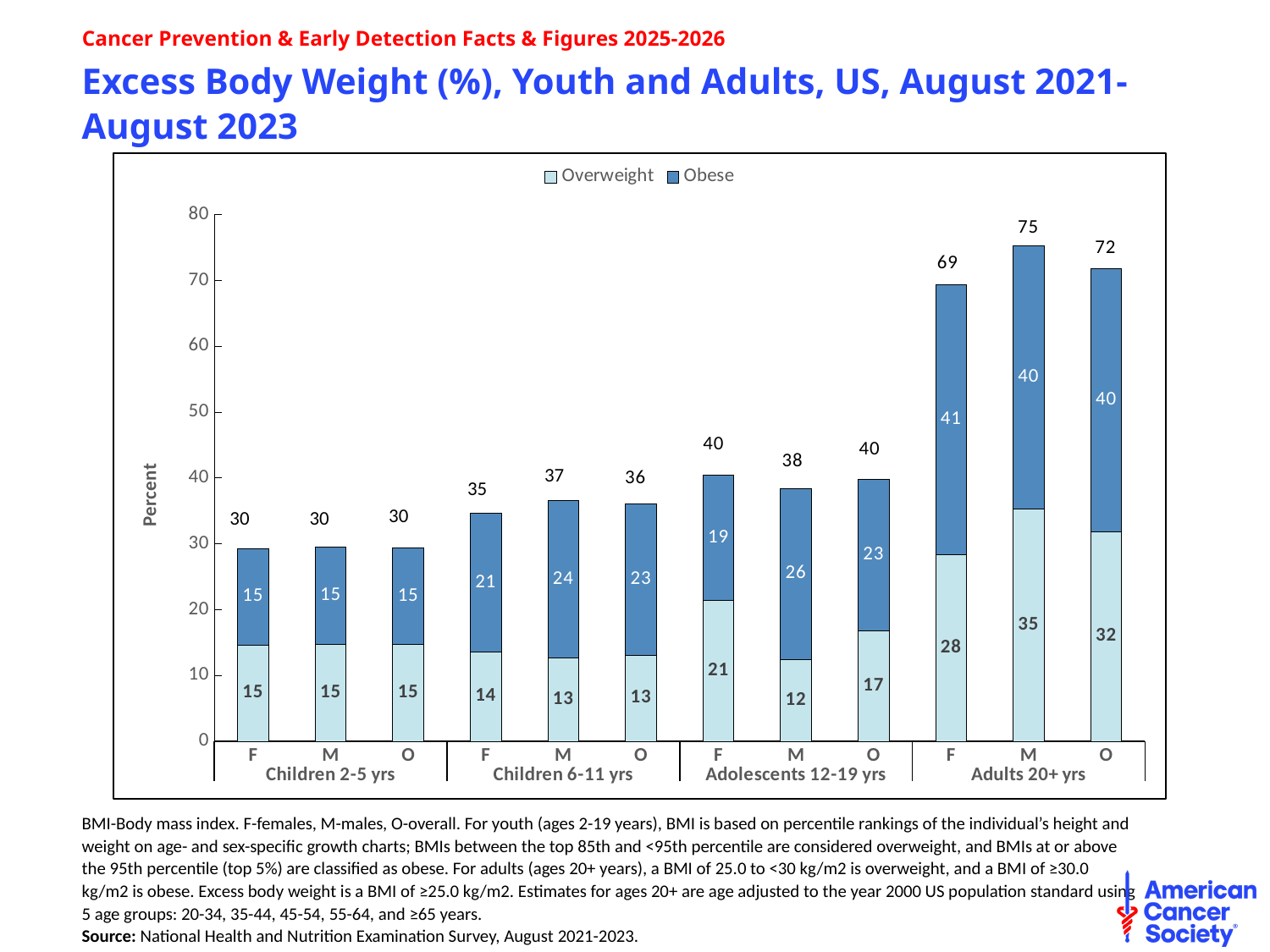
What is the Overweight value for males (M) in the Adolescents 12-19 yrs group? 12 What is the difference between the Obese value for females (F) in Adults 20+ yrs and the Obese value for females (F) in Children 6-11 yrs? 20 Do the total excess body weight percentages generally rise or fall moving from the youngest age group on the left to the oldest on the right? Rise What is the label on the vertical axis of the chart? Percent Which bar has the highest total excess body weight percentage? Adults 20+ yrs, M What is the Obese value for females (F) in the Adults 20+ yrs group? 41 Which bar has the lowest Overweight value? Adolescents 12-19 yrs, M How many bars are plotted in the chart? 12 How many series does the legend list? 2 What is the total excess body weight percentage for males (M) in the Adults 20+ yrs group? 75 Which is larger: the Overweight value for M or for O in the Adults 20+ yrs group? M What kind of chart is shown on the slide? Stacked bar chart